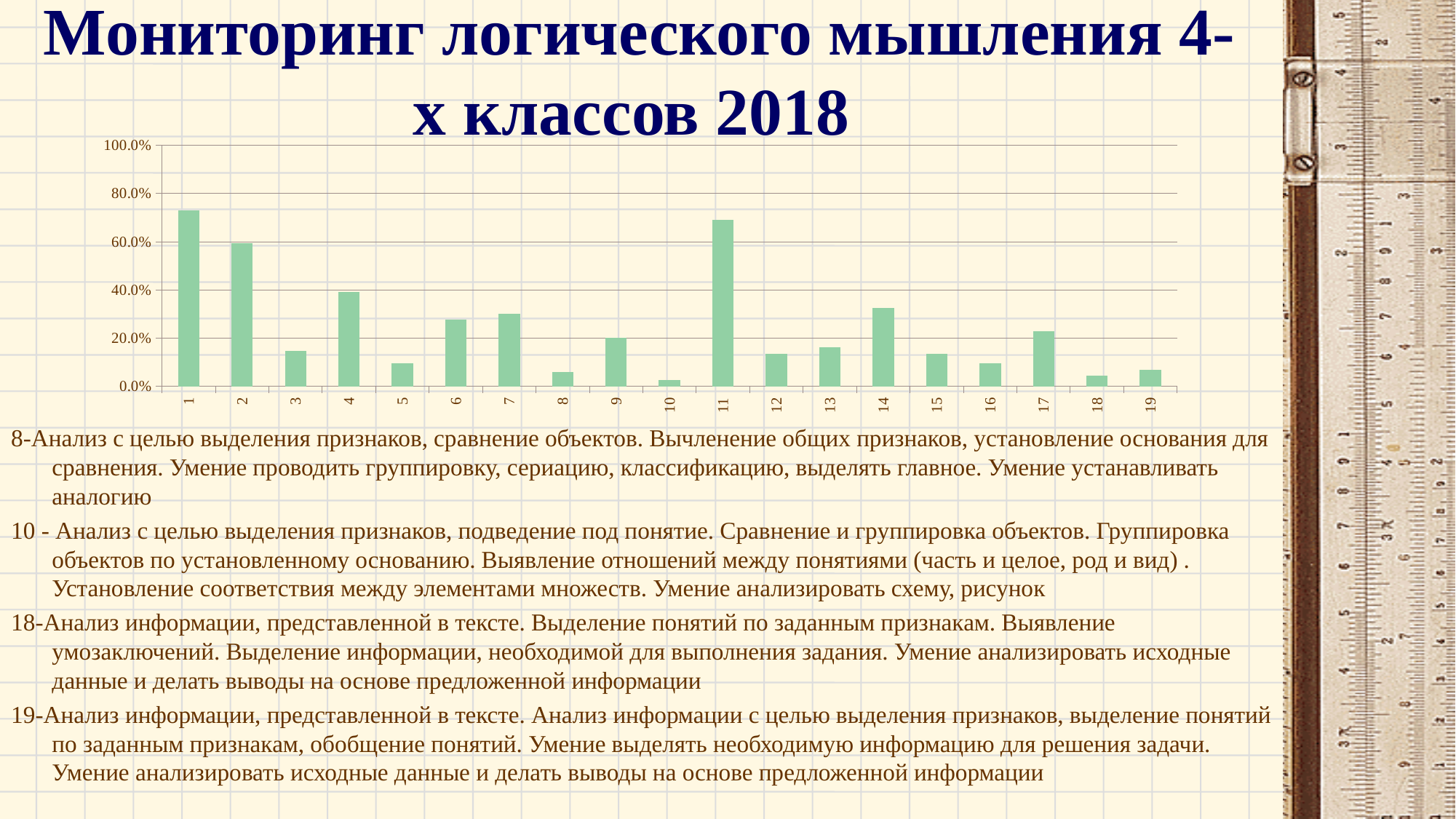
What kind of chart is shown on the slide? bar chart Which has the larger value, category 2 or category 4? 2 Is the value for category 2 greater or less than 80.0%? less How many categories are plotted along the x axis of the chart? 19 Is the value for category 10 greater or less than 20.0%? less Which category has the highest value in the chart? 1 Which has the larger value, category 1 or category 11? 1 Is the value for category 1 greater or less than 60.0%? greater Which category has the lowest value in the chart? 10 What is the title of the slide containing the chart? Мониторинг логического мышления 4-х классов 2018